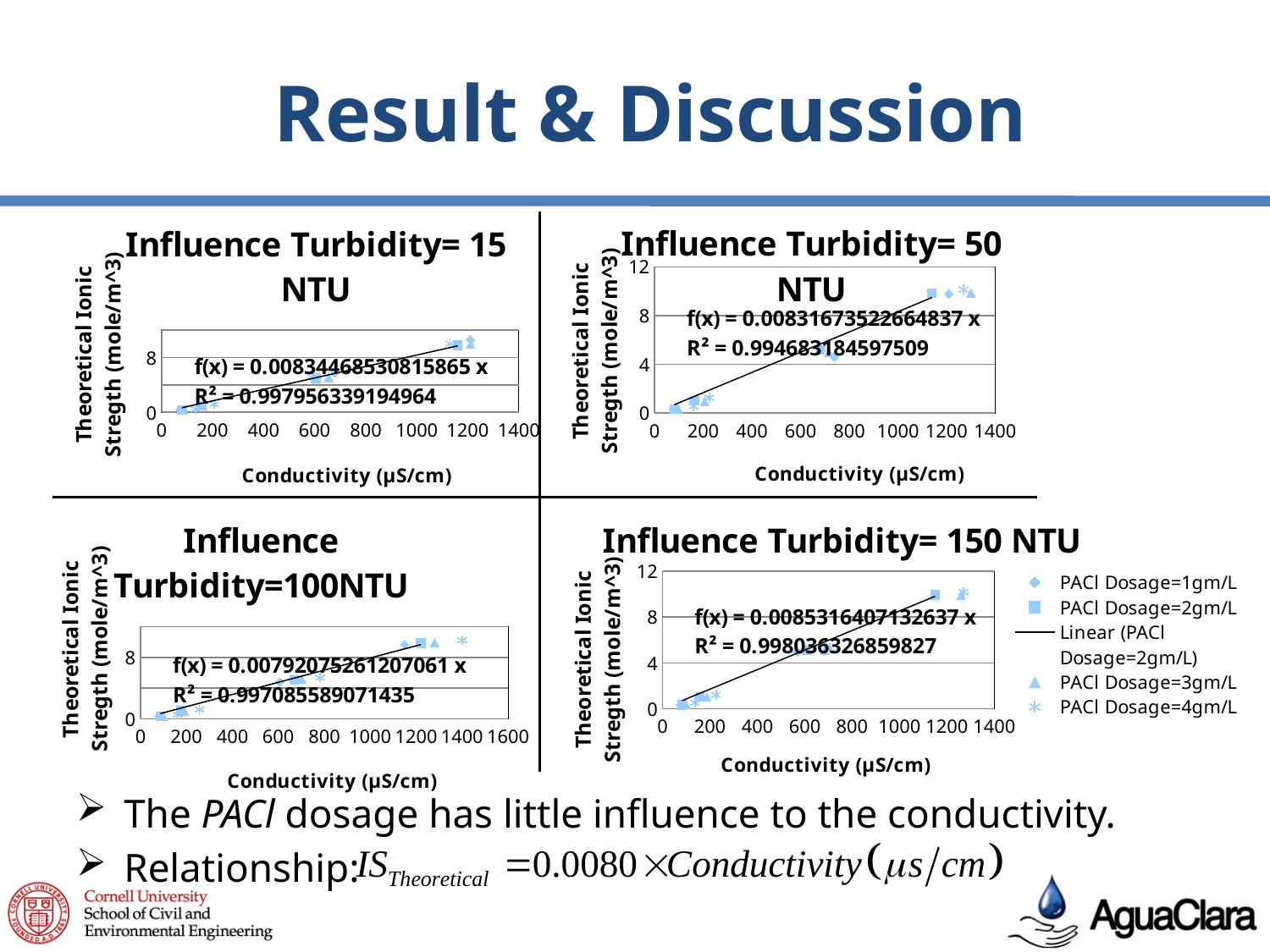
In the "Influence Turbidity= 150 NTU" chart, what is the R² value shown? R² = 0.998036326859827 What kind of chart is the "Influence Turbidity= 15 NTU" chart? scatter chart In the "Influence Turbidity= 50 NTU" chart, what is the fitted equation f(x) shown? f(x) = 0.00831673522664837 x Across the four charts, which influence turbidity has the lowest slope in its fitted equation? 100 NTU In the "Influence Turbidity= 15 NTU" chart, what is the R² value shown? R² = 0.997956339194964 In the "Influence Turbidity=100NTU" chart, what is the fitted equation f(x) shown? f(x) = 0.00792075261207061 x How many entries does the legend next to the "Influence Turbidity= 150 NTU" chart list? 5 Is the R² value in the "Influence Turbidity= 50 NTU" chart larger or smaller than the R² value in the "Influence Turbidity= 15 NTU" chart? smaller What is the x-axis label on the "Influence Turbidity=100NTU" chart? Conductivity (µS/cm) Across the four charts, which influence turbidity has the highest R² value? 150 NTU In the "Influence Turbidity= 50 NTU" chart, do the theoretical ionic strength values rise or fall as conductivity increases? rise In the "Influence Turbidity= 150 NTU" chart, is the theoretical ionic strength for the points near 1200 µS/cm greater or less than 8? greater